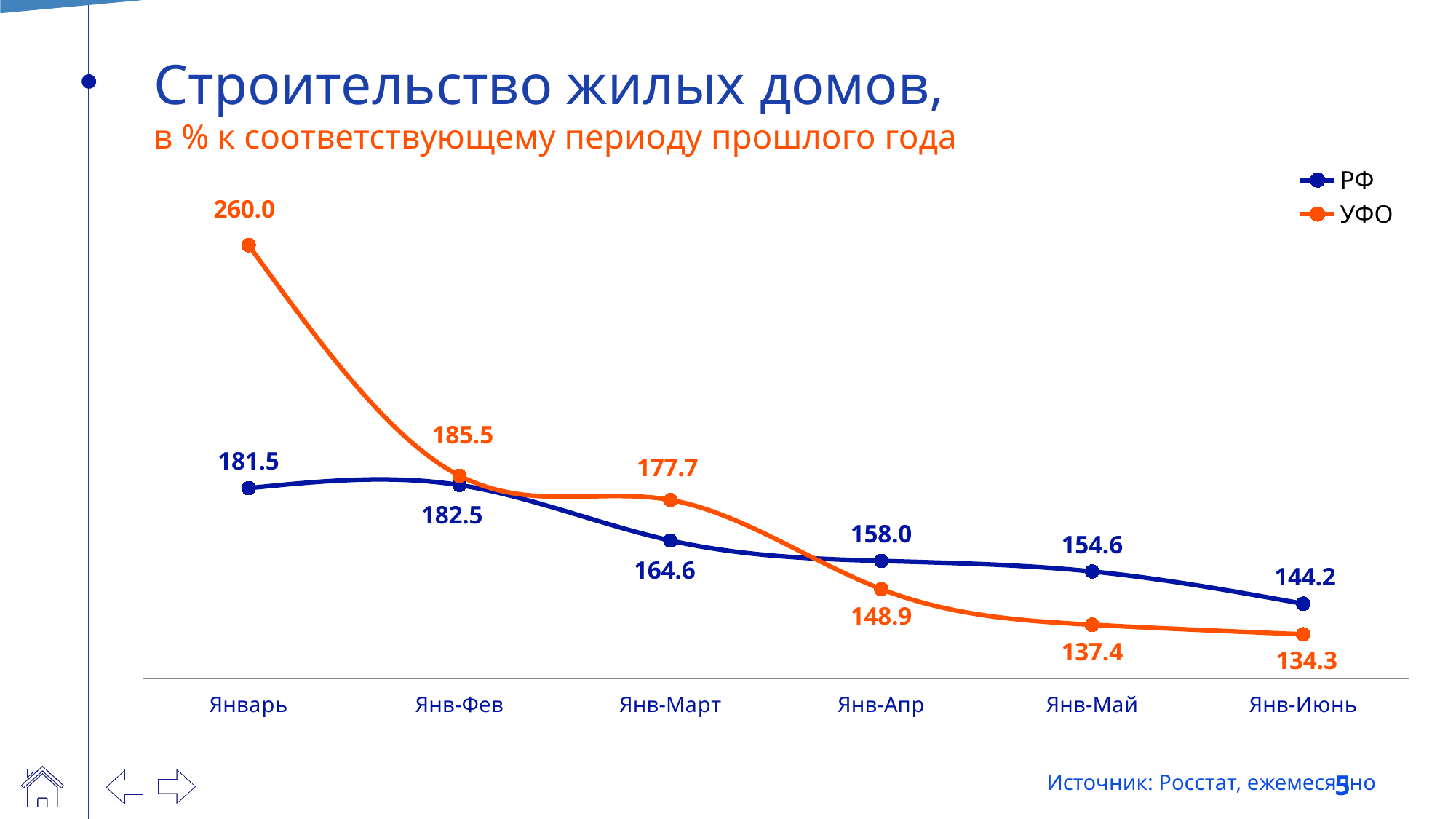
Which series has the larger value in Янв-Апр, РФ or УФО? РФ What kind of chart is shown on the slide? Line chart What is the difference between the УФО and РФ values in Январь? 78.5 What is the value for УФО in Янв-Июнь? 134.3 How many series does the legend list? 2 What is the value for РФ in Янв-Март? 164.6 How many periods are shown on the x axis? 6 In which period is the РФ series lowest? Янв-Июнь What is the value for УФО in Январь? 260.0 What is the value for РФ in Янв-Май? 154.6 In which period is the УФО series highest? Январь Does the УФО series rise or fall from Январь to Янв-Июнь? Fall